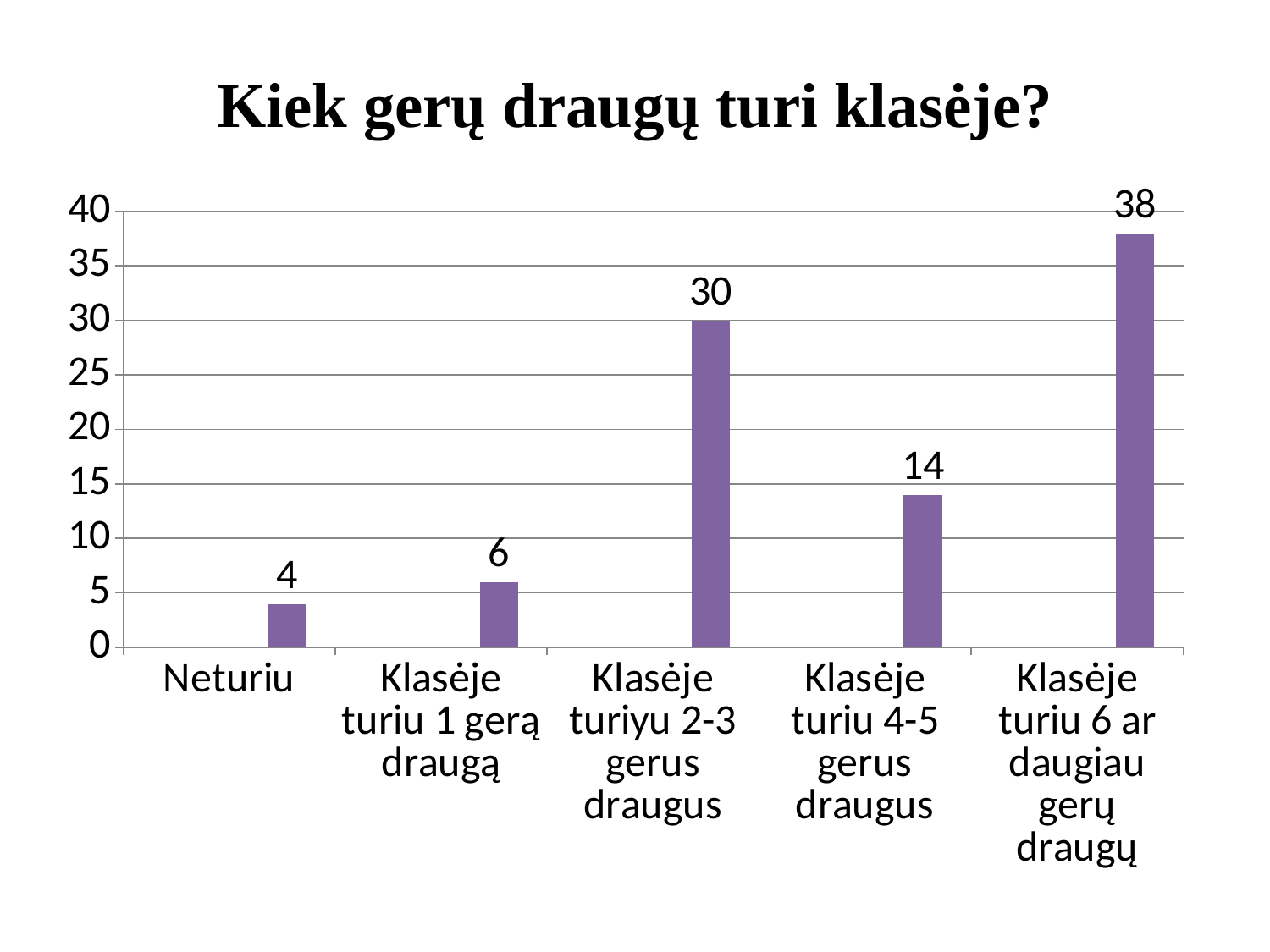
Which category has the lowest value? Neturiu What is the difference between the values for "Klasėje turiu 6 ar daugiau gerų draugų" and "Klasėje turiyu 2-3 gerus draugus"? 8 Which category has the highest value? Klasėje turiu 6 ar daugiau gerų draugų How many categories are shown on the x axis? 5 What is the title of the chart? Kiek gerų draugų turi klasėje? Which is larger: the value for "Klasėje turiyu 2-3 gerus draugus" or "Klasėje turiu 4-5 gerus draugus"? Klasėje turiyu 2-3 gerus draugus What is the value for "Neturiu"? 4 What is the difference between the values for "Klasėje turiu 1 gerą draugą" and "Neturiu"? 2 What kind of chart is shown on the slide? bar chart What is the value for "Klasėje turiu 6 ar daugiau gerų draugų"? 38 What is the value for "Klasėje turiu 4-5 gerus draugus"? 14 Is the value for "Klasėje turiu 4-5 gerus draugus" greater or less than 20? less